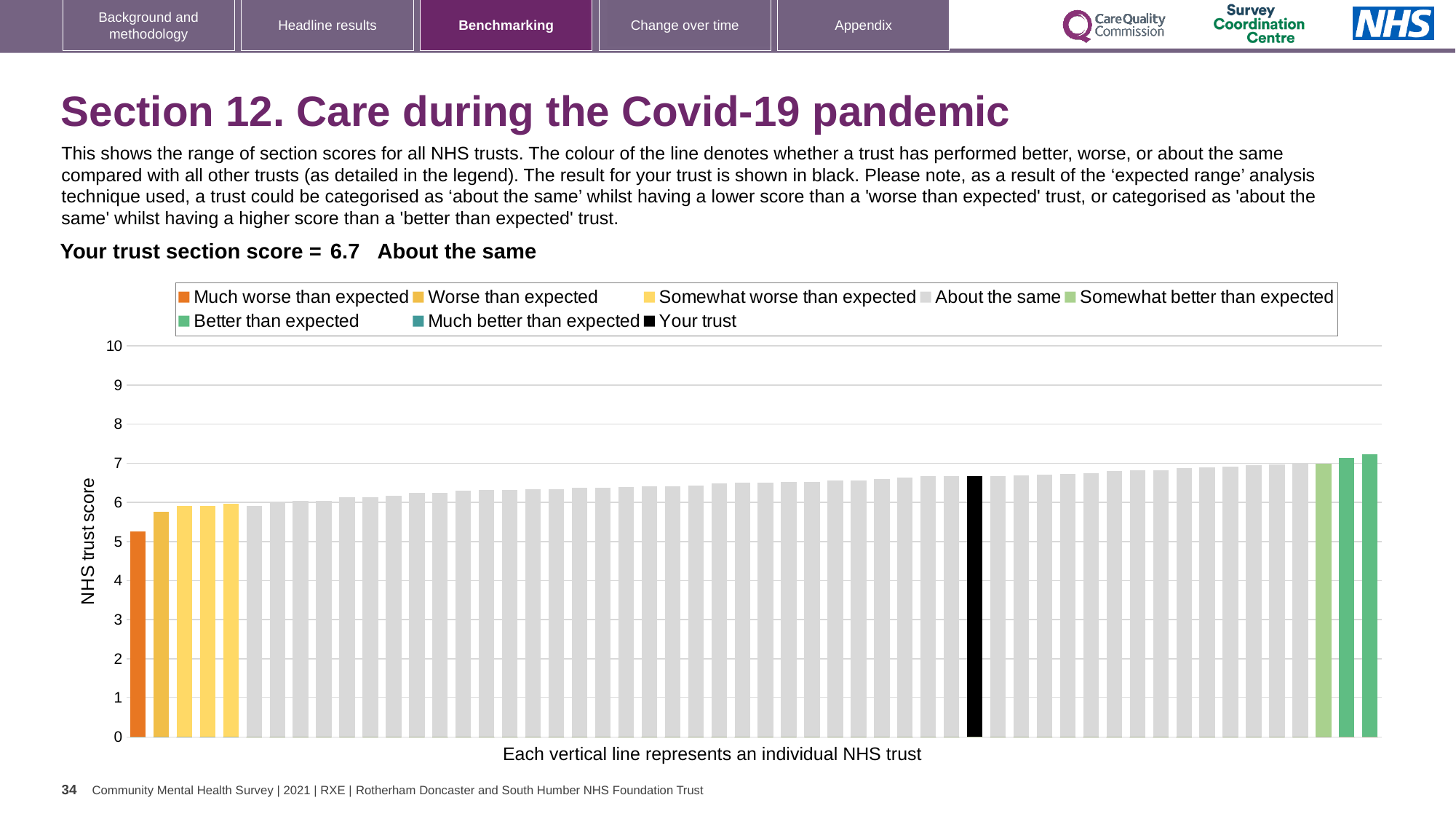
Is the value of the orange 'Much worse than expected' bar greater or less than 6? less Which is larger: the black 'Your trust' bar or the orange 'Much worse than expected' bar? Your trust Is the value of the black 'Your trust' bar greater or less than 7? less What is the section score for your trust shown on the slide? 6.7 How many entries does the chart legend list? 8 Is the value of the tallest bar on the chart greater or less than 6? greater What kind of chart is shown on the slide? bar chart What is the title of the vertical axis? NHS trust score How many bars are coloured orange for 'Much worse than expected'? 1 Do the bar values rise or fall moving from left to right along the x axis? rise Which category is your trust placed in for this section? About the same How many bars are coloured for 'Better than expected'? 2